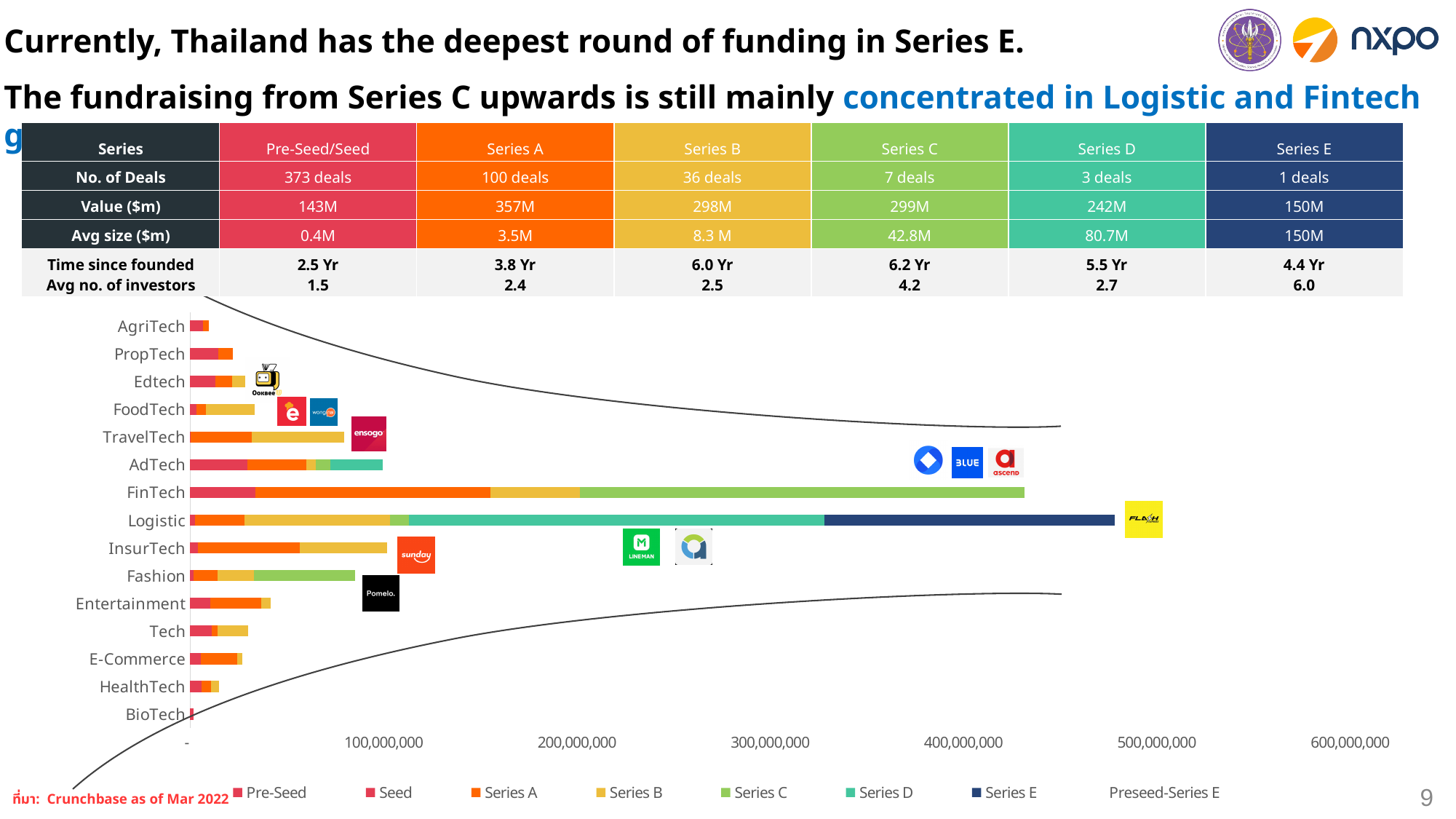
What kind of chart is shown on the slide? bar chart Is the total value for Logistic greater or less than 400,000,000? greater Is the total value for TravelTech greater or less than 100,000,000? less Is the total value for Fashion greater or less than 100,000,000? less What is the highest value labelled on the horizontal axis of the chart? 600,000,000 Which sector has a longer total bar, Logistic or FinTech? Logistic Which sector has the longest total bar in the chart? Logistic Which sector has the shortest total bar in the chart? BioTech How many categories (sectors) are listed on the vertical axis of the bar chart? 15 Which sector has a longer total bar, AgriTech or PropTech? PropTech Which sector's bar contains a Series E segment? Logistic